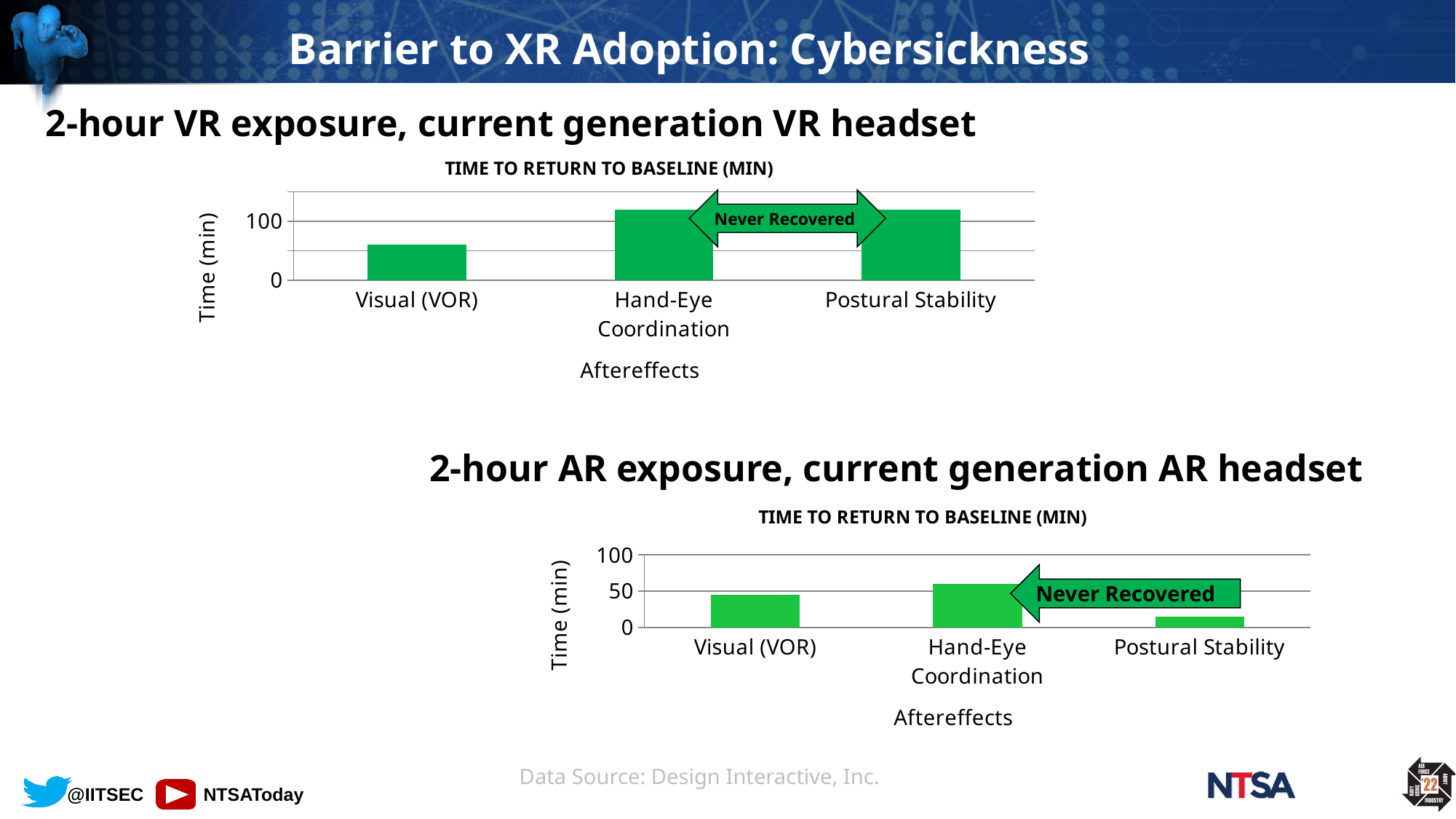
In the bottom (AR) chart, which category has the lowest time to return to baseline? Postural Stability In the bottom (AR) chart, is the value for Hand-Eye Coordination greater or less than 50? greater What kind of chart is the top chart, titled '2-hour VR exposure, current generation VR headset'? bar chart In the top (VR) chart, which category has the lowest time to return to baseline? Visual (VOR) In the top (VR) chart, is the value for Visual (VOR) greater or less than 100? less How many categories are shown on the x axis of the top (VR) chart? 3 What label is shown on the arrow spanning the Hand-Eye Coordination and Postural Stability bars in the top (VR) chart? Never Recovered In the top (VR) chart, which is larger: the value for Visual (VOR) or the value for Postural Stability? Postural Stability In the bottom (AR) chart, is the value for Postural Stability greater or less than 50? less In the bottom (AR) chart, which category has the highest time to return to baseline? Hand-Eye Coordination What is the x-axis title of the bottom (AR) chart? Aftereffects